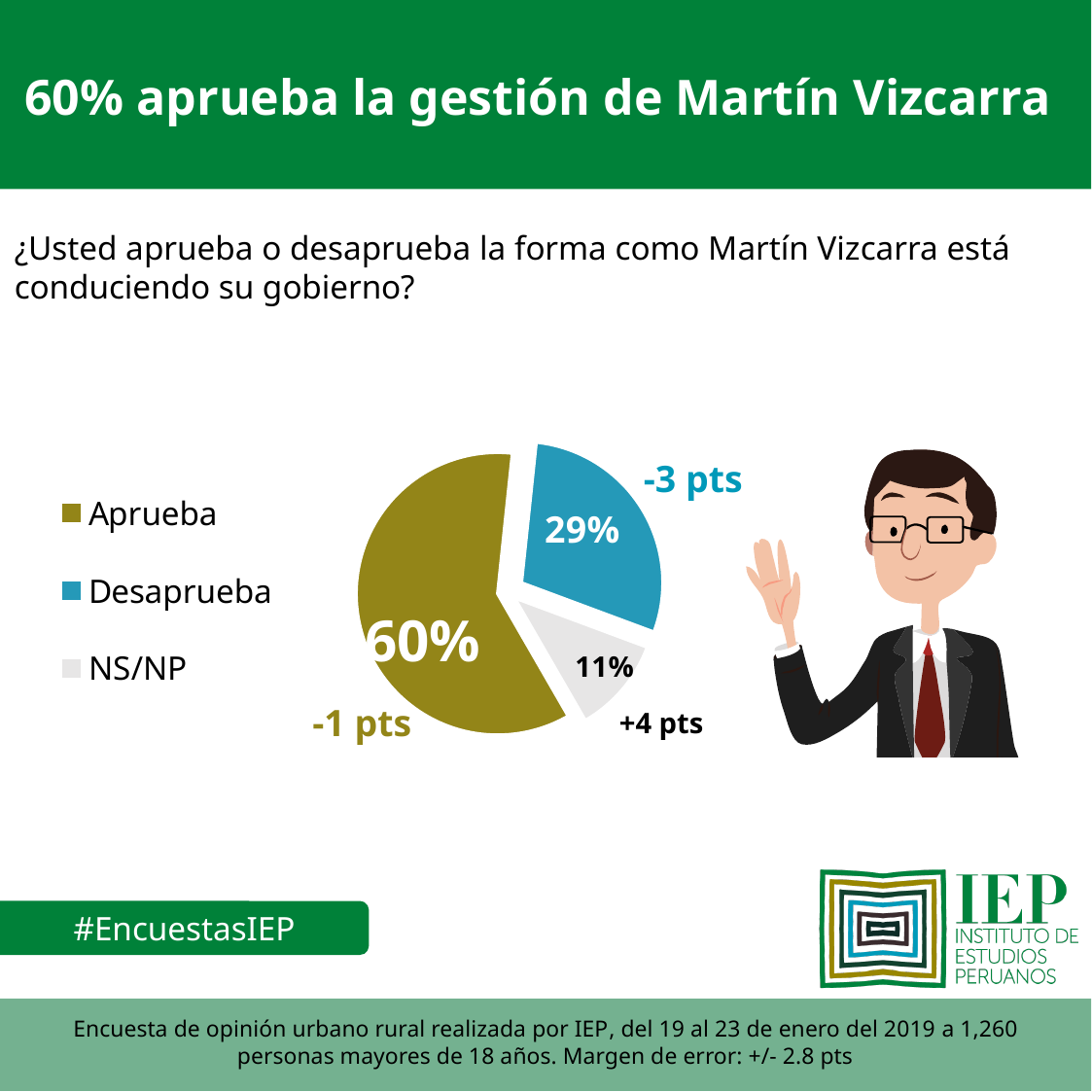
How many categories does the pie chart show? 3 What percentage of respondents disapprove (Desaprueba)? 29% What change in points is shown next to the NS/NP slice? +4 pts What is the difference in percentage points between Aprueba and Desaprueba? 31 What colour is the Aprueba slice in the pie chart? Olive/gold Which category has the largest share of the pie? Aprueba What percentage of respondents approve (Aprueba) of Martín Vizcarra's management? 60% Which category has the smallest share of the pie? NS/NP Which is larger, the Desaprueba share or the NS/NP share? Desaprueba What percentage of respondents answered NS/NP? 11% What kind of chart is shown on the slide? Pie chart What change in points is shown next to the Desaprueba slice? -3 pts